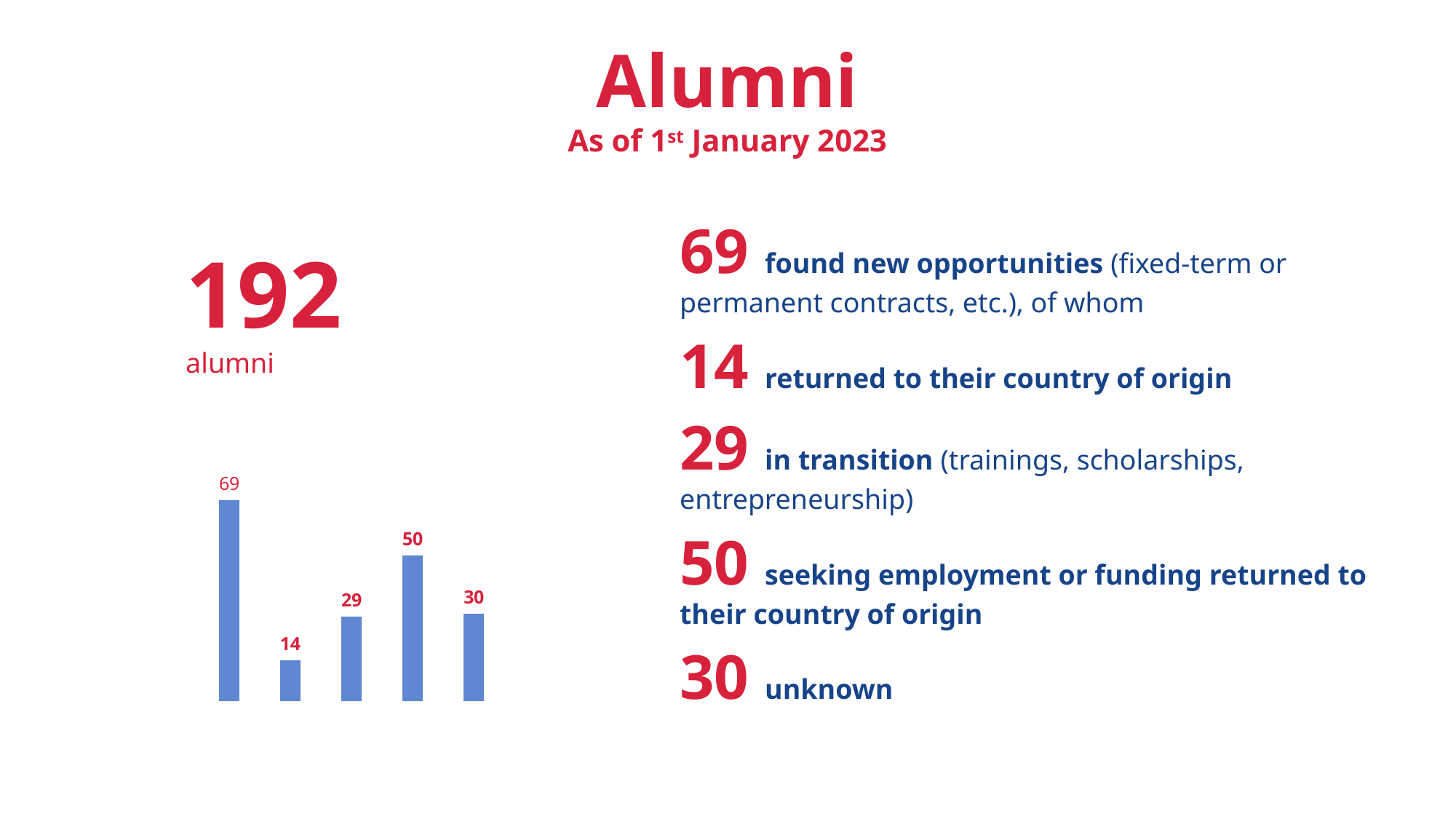
What is the value shown on the fourth bar of the chart? 50 What type of chart is shown on the slide? bar chart What is the value shown on the last (rightmost) bar of the chart? 30 Which is larger, the third bar (29) or the fifth bar (30)? the fifth bar (30) What is the difference between the highest bar value (69) and the lowest bar value (14)? 55 What total number of alumni is stated on the slide next to the chart? 192 Which bar has the lowest value in the chart? the second bar (14) How many bars does the chart contain? 5 What is the value shown on the second bar of the chart? 14 What is the value shown on the first (leftmost) bar of the chart? 69 Which bar has the highest value in the chart? the first bar (69) What is the difference between the fourth bar (50) and the third bar (29)? 21